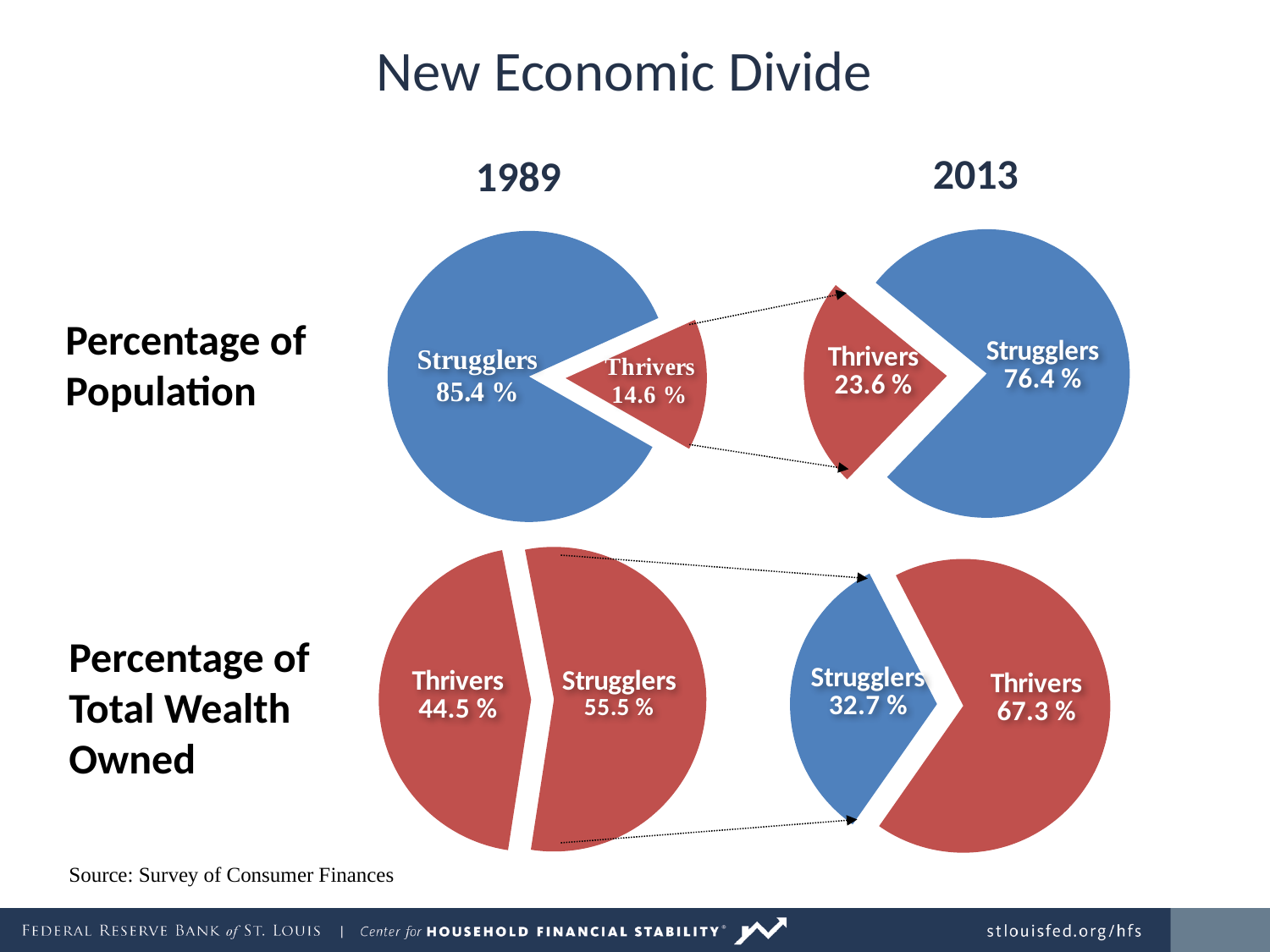
How many pie charts are shown on the slide? 4 In the 2013 Percentage of Population pie chart, what share of the population are Thrivers? 23.6 % In the 1989 Percentage of Total Wealth Owned pie chart, what share of wealth do Thrivers own? 44.5 % In the 2013 Percentage of Total Wealth Owned pie chart, what share of wealth do Thrivers own? 67.3 % Comparing the 1989 and 2013 Percentage of Total Wealth Owned pie charts, which year shows a larger share of wealth owned by Strugglers? 1989 In the 2013 Percentage of Population pie chart, what share of the population are Strugglers? 76.4 % In the 1989 Percentage of Population pie chart, what share of the population are Thrivers? 14.6 % In the 1989 Percentage of Total Wealth Owned pie chart, which group has the smaller slice? Thrivers What kind of chart is used on this slide to show the Percentage of Population? Pie chart In the 2013 Percentage of Population pie chart, what is the difference between the Strugglers and Thrivers shares? 52.8 % In the 1989 Percentage of Population pie chart, what share of the population are Strugglers? 85.4 % In the 2013 Percentage of Total Wealth Owned pie chart, which group has the larger slice? Thrivers